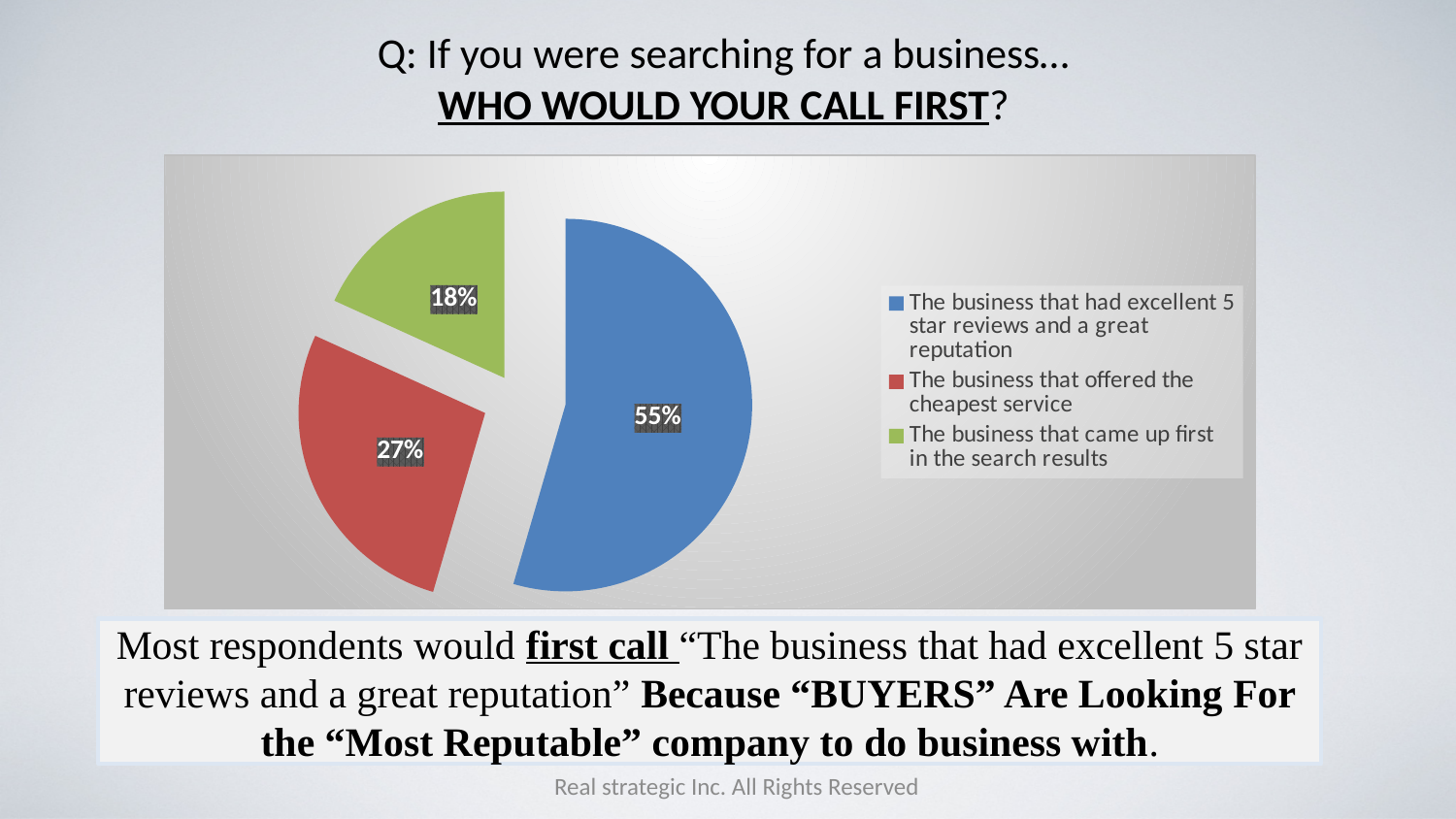
What percentage of respondents would first call the business that came up first in the search results? 18% Which is larger: the share for the business that offered the cheapest service or the share for the business that came up first in the search results? The business that offered the cheapest service What percentage of respondents would first call the business that offered the cheapest service? 27% What kind of chart is shown on the slide? Pie chart Which option has the smallest share of the pie? The business that came up first in the search results What percentage of respondents would first call the business that had excellent 5 star reviews and a great reputation? 55% What is the difference in percentage points between the business that offered the cheapest service and the business that came up first in the search results? 9 How many slices does the pie chart have? 3 What is the difference in percentage points between the business with excellent 5 star reviews and the business that offered the cheapest service? 28 What colour is the slice for the business that offered the cheapest service? Red What colour is the slice for the business that came up first in the search results? Green Which option has the largest share of the pie? The business that had excellent 5 star reviews and a great reputation